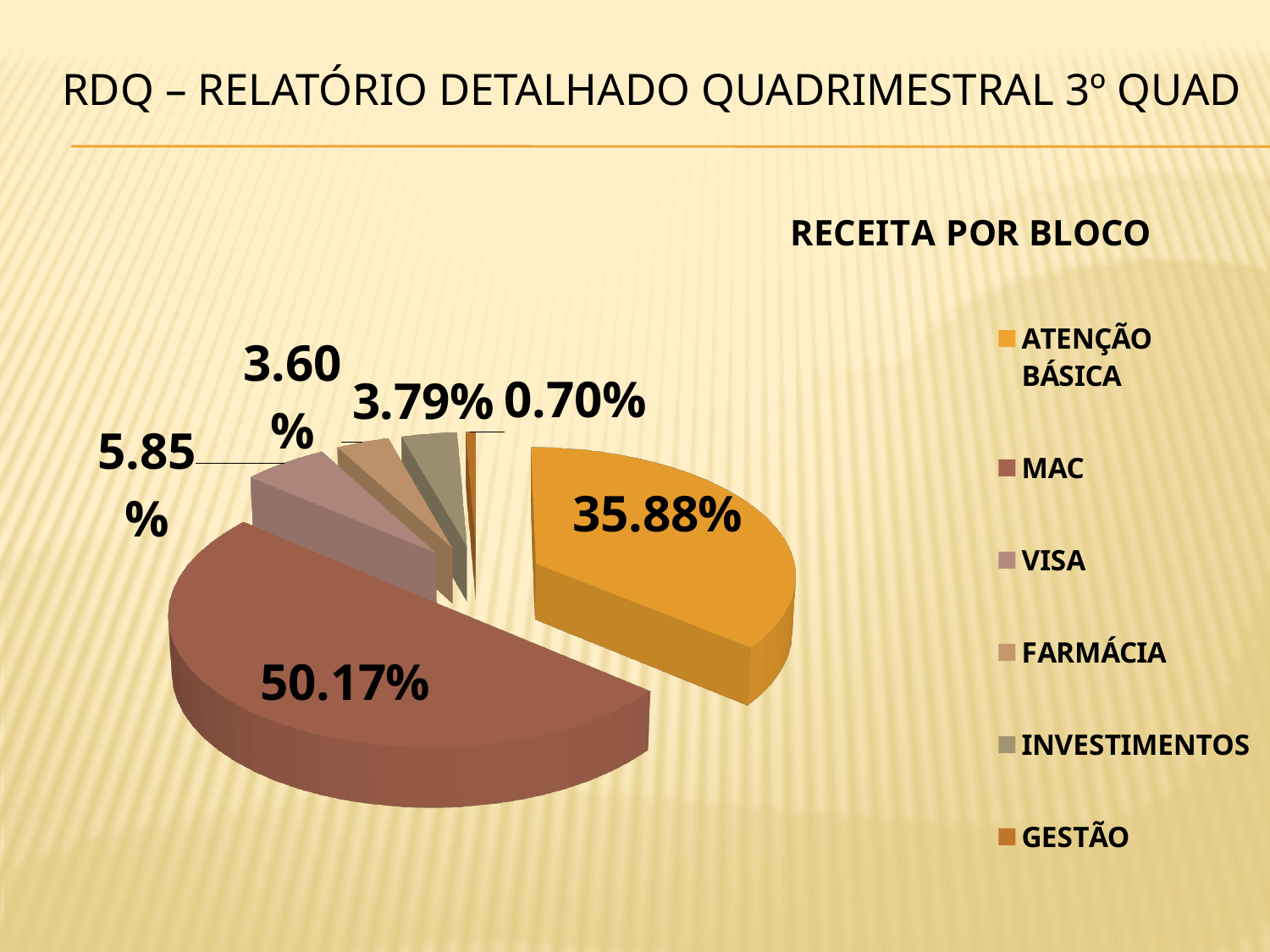
Which category has the largest slice of the pie? MAC Which is larger, the INVESTIMENTOS slice or the FARMÁCIA slice? INVESTIMENTOS What is the title of the chart? RECEITA POR BLOCO What share of the pie does MAC represent? 50.17% What share of the pie does GESTÃO represent? 0.70% How many categories does the legend of the pie chart list? 6 What share of the pie does ATENÇÃO BÁSICA represent? 35.88% Which category has the smallest slice of the pie? GESTÃO What is the difference in percentage points between the MAC slice and the ATENÇÃO BÁSICA slice? 14.29 Which category is shown in brown in the pie chart? MAC What type of chart is shown on the slide? pie chart